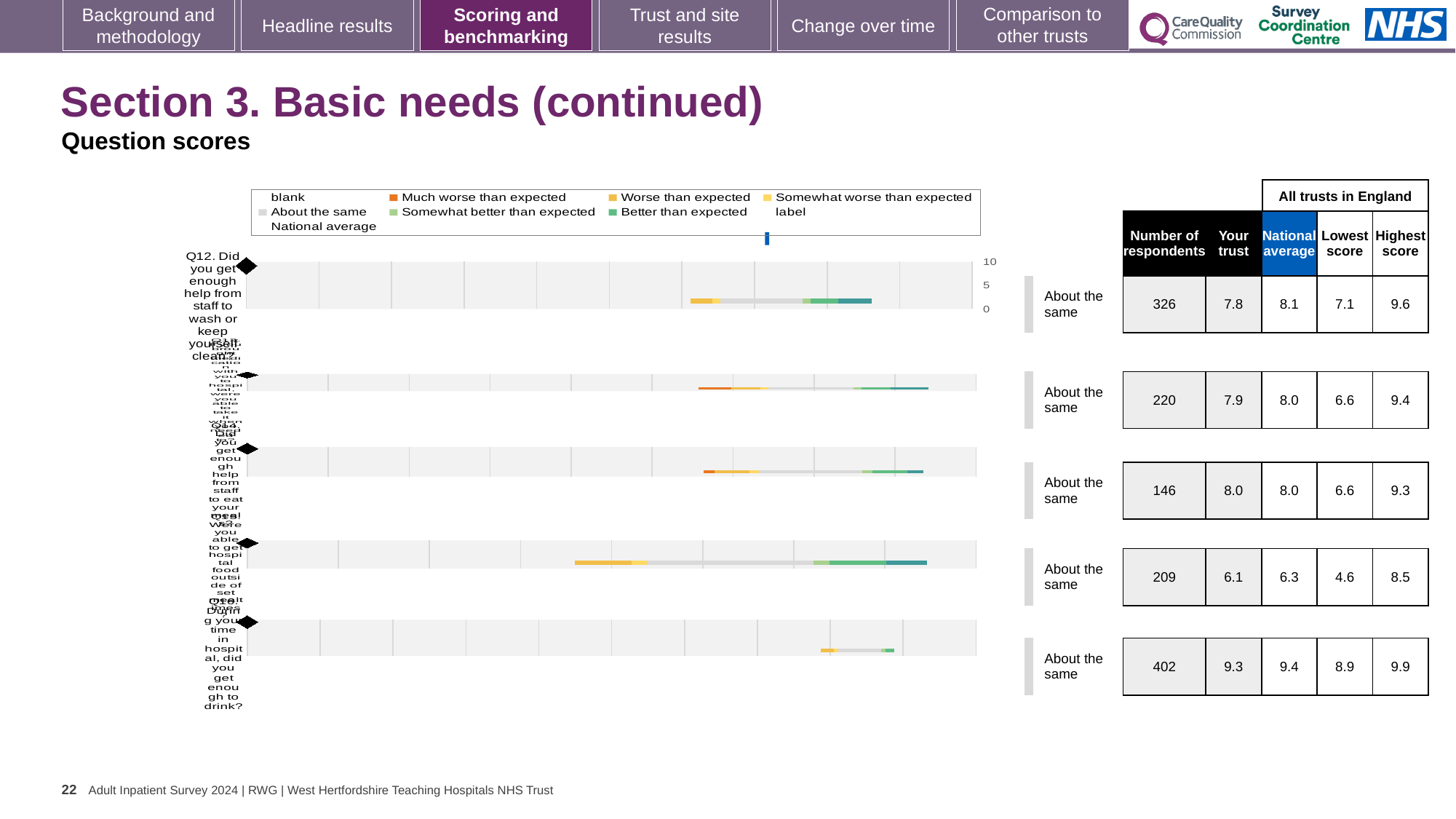
What is the highest 'Your trust' score listed in the table beside the chart? 9.3 In the table beside the chart, what is the highest score in England for Q12? 9.6 In the table beside the chart, what is the national average for Q12? 8.1 How many question rows (bars) does the chart show? 5 In the table beside the chart, how many respondents are listed for Q12? 326 What kind of chart is shown on the slide? bar chart For the fourth row of the table (209 respondents), which is larger: the 'Your trust' score or the national average? National average Which colour in the legend represents 'Much worse than expected'? Orange In the table beside the chart, what is the 'Your trust' score for Q12 (help from staff to wash or keep yourself clean)? 7.8 For Q12, how much higher is the national average (8.1) than the 'Your trust' score (7.8)? 0.3 What is the lowest 'Your trust' score listed in the table beside the chart? 6.1 What benchmark rating is shown next to every question row on the chart? About the same